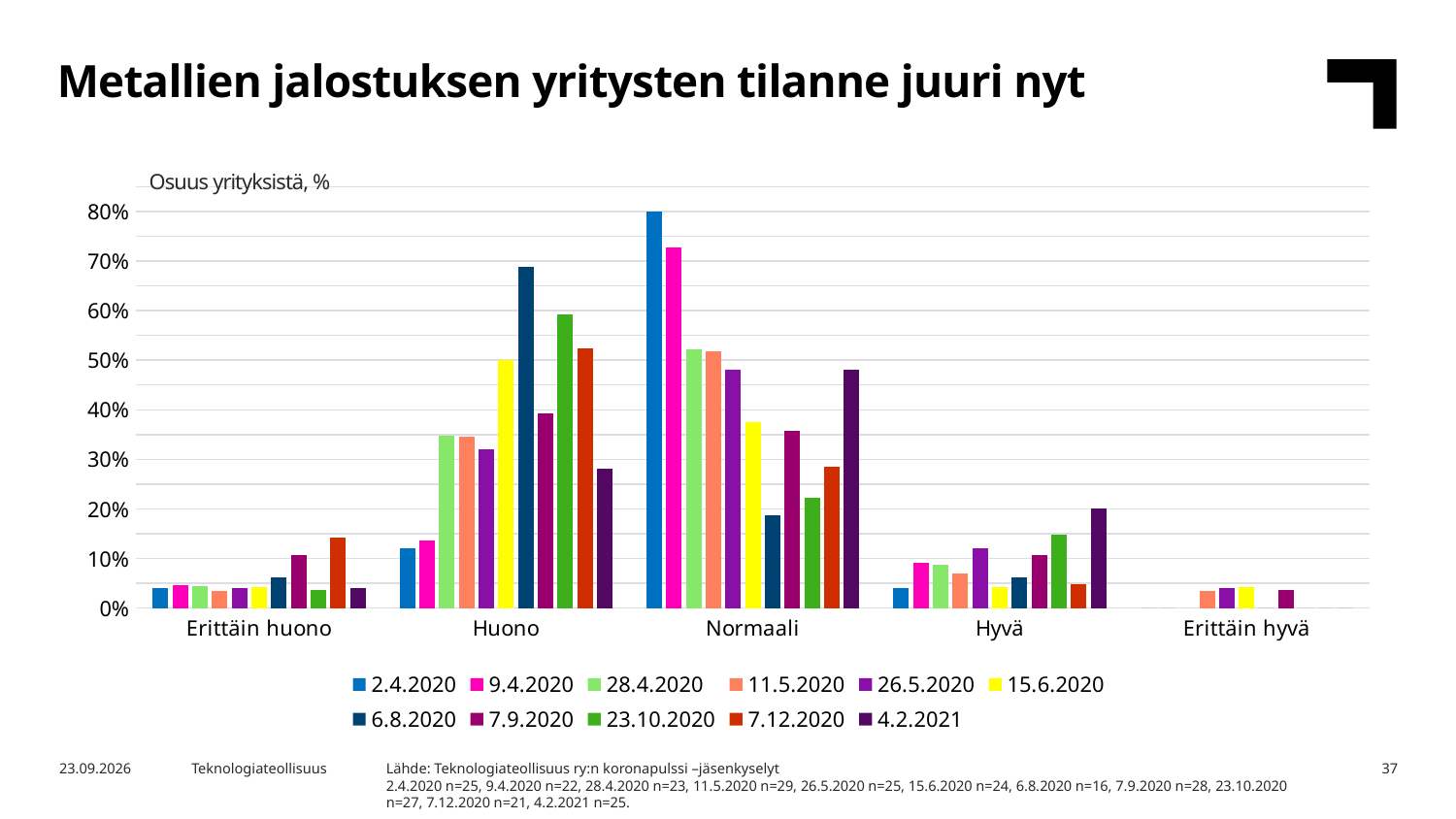
In the Huono category, which is larger: the value for 23.10.2020 or for 7.12.2020? 23.10.2020 Is the value for 6.8.2020 in the Huono category greater or less than 60%? greater Is the value for 4.2.2021 in the Normaali category greater or less than 40%? greater Is the value for 6.8.2020 in the Normaali category greater or less than 30%? less What is the title of the chart? Metallien jalostuksen yritysten tilanne juuri nyt Which category has the highest bar for the 2.4.2020 series? Normaali What kind of chart is shown on the slide? bar chart What is the label on the vertical axis? Osuus yrityksistä, % Which series has the highest value in the Hyvä category? 4.2.2021 How many series does the legend list? 11 Which series has the highest value in the Huono category? 6.8.2020 How many categories are shown on the x axis? 5